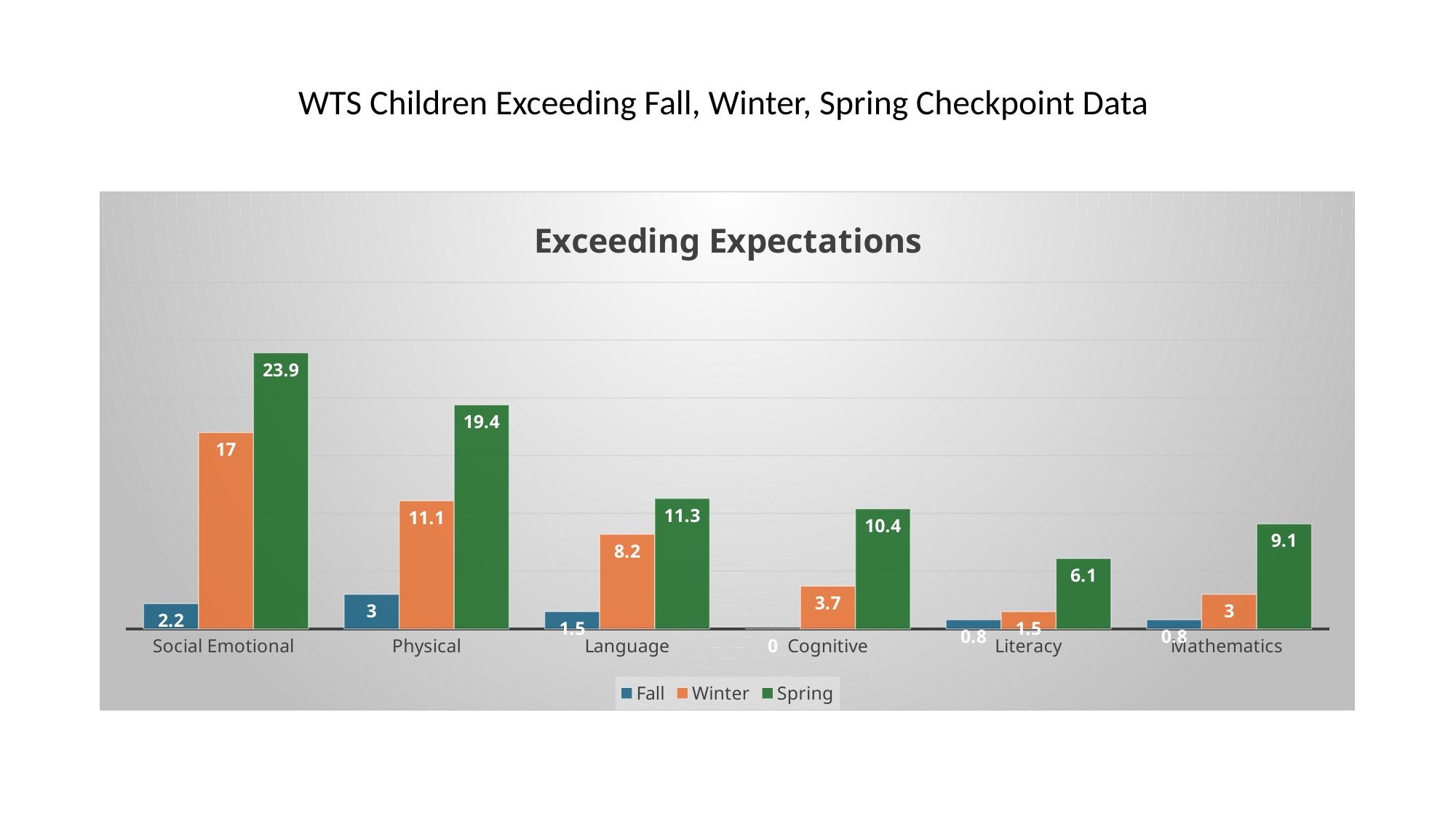
What is the Fall value for Cognitive? 0 What is the Winter value for Physical? 11.1 What kind of chart is shown? Bar chart What is the Spring value for Mathematics? 9.1 Which category has the lowest Winter value? Literacy Which is larger, the Spring value for Language or the Spring value for Cognitive? Language What is the difference between the Spring and Winter values for Social Emotional? 6.9 What is the title of the chart? Exceeding Expectations How many series does the legend list? 3 How many categories are shown on the x axis? 6 Which category has the highest Spring value? Social Emotional What is the Spring value for Social Emotional? 23.9